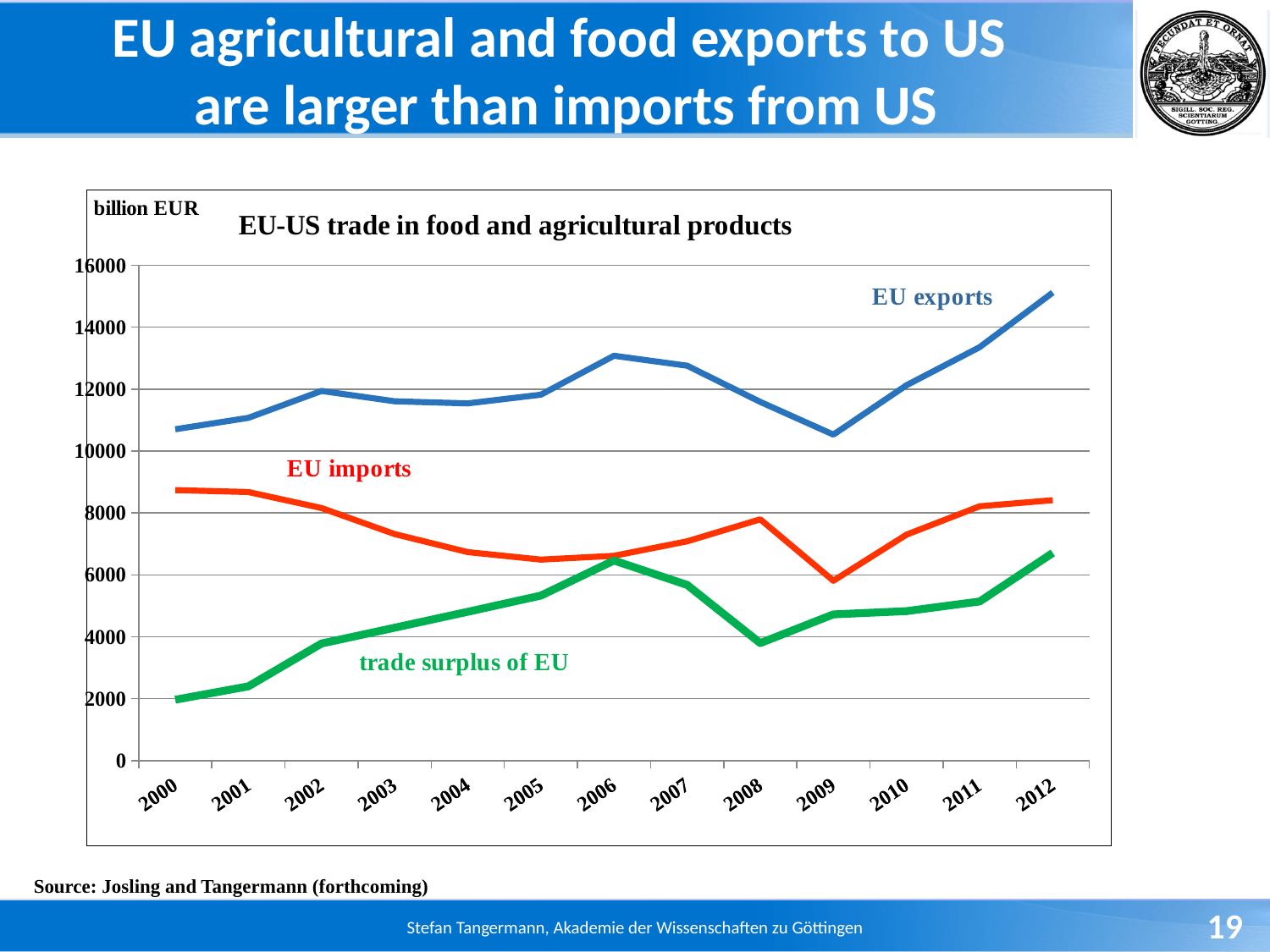
Is the value for EU exports in 2009 greater or less than 12000? less Is the value for EU exports in 2012 greater or less than 14000? greater How many years are shown along the x axis of the chart? 13 In which year is the trade surplus of EU at its lowest? 2000 In which year is EU exports at its highest? 2012 Is the trade surplus of EU in 2012 greater or less than 6000? greater How many data series are plotted in the chart? 3 In which year is EU imports at its lowest? 2009 Do EU exports rise or fall from 2009 to 2012? rise What kind of chart is shown on the slide? line chart Which is larger in 2012, EU exports or EU imports? EU exports